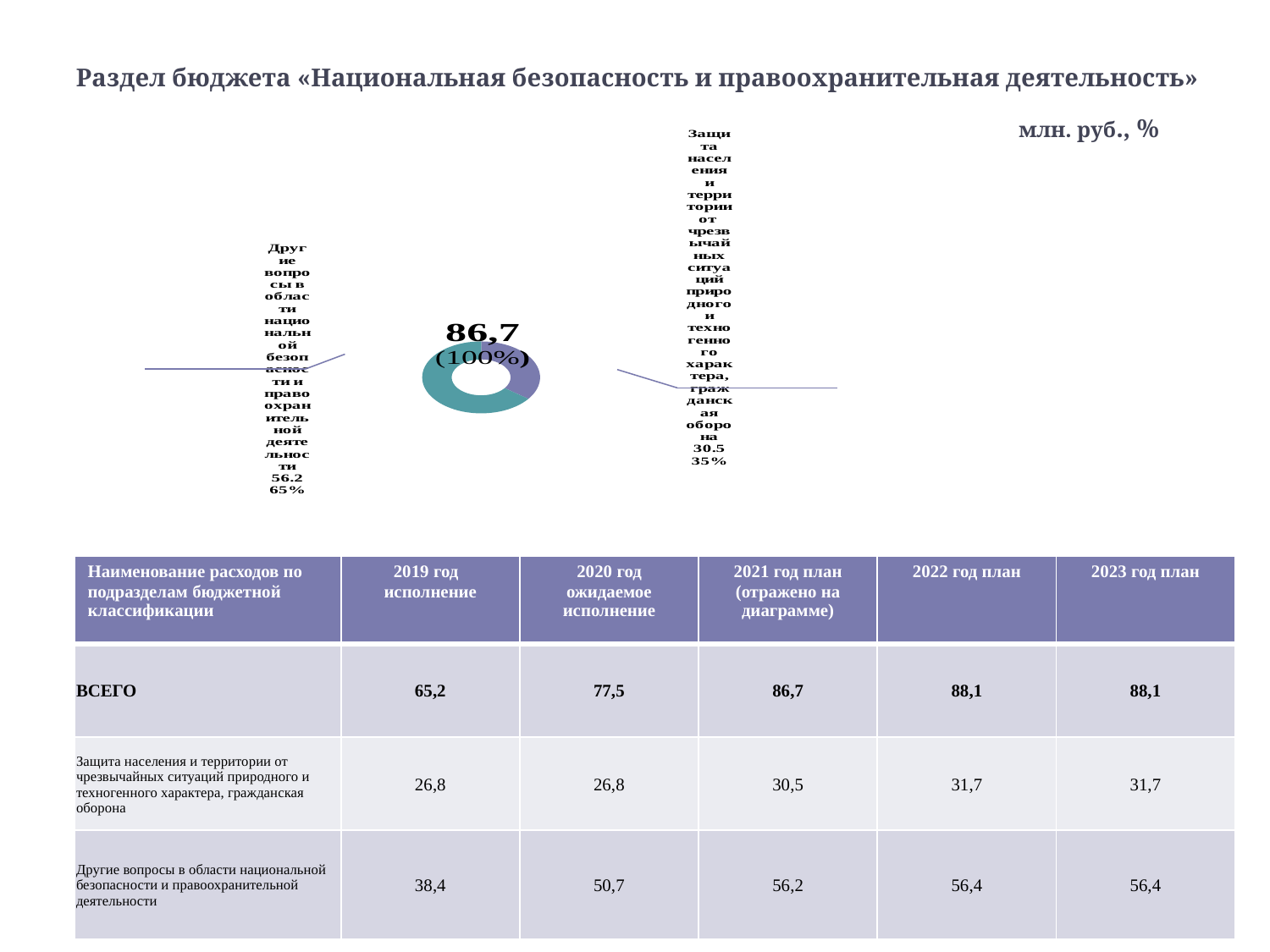
How many slices does the doughnut chart have? 2 What kind of chart is shown on the slide? Doughnut chart Which slice of the doughnut chart is the largest? Другие вопросы в области национальной безопасности и правоохранительной деятельности What total value is shown in the centre of the doughnut chart? 86,7 (100%) What percentage share does the slice "Защита населения и территории от чрезвычайных ситуаций природного и техногенного характера, гражданская оборона" have? 35% Which slice of the doughnut chart is the smallest? Защита населения и территории от чрезвычайных ситуаций природного и техногенного характера, гражданская оборона What value is shown for the slice "Другие вопросы в области национальной безопасности и правоохранительной деятельности"? 56.2 What value is shown for the slice "Защита населения и территории от чрезвычайных ситуаций природного и техногенного характера, гражданская оборона"? 30.5 What percentage share does the slice "Другие вопросы в области национальной безопасности и правоохранительной деятельности" have? 65% Which is larger: the slice for "Другие вопросы..." or the slice for "Защита населения..."? Другие вопросы в области национальной безопасности и правоохранительной деятельности What unit is indicated for the chart on the slide? млн. руб., % What is the difference between the values of the two slices (56.2 and 30.5)? 25.7